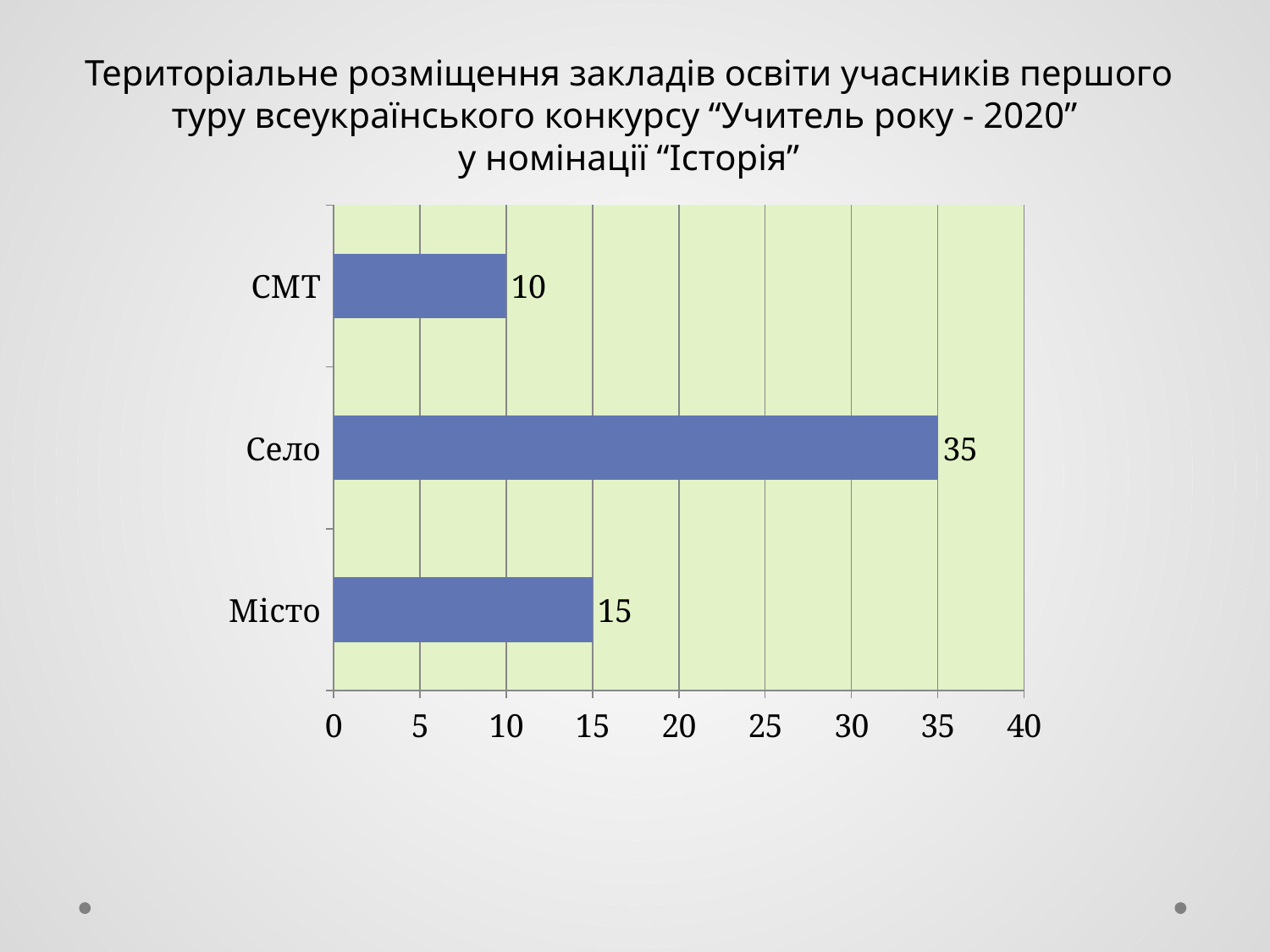
Which category has the highest value? Село What is the value for Село? 35 How many categories are shown in the chart? 3 What is the difference between the values for Місто and СМТ? 5 What is the value for Місто? 15 Which is larger, the value for Місто or the value for СМТ? Місто What is the maximum value shown on the horizontal axis? 40 What is the value for СМТ? 10 Which category has the lowest value? СМТ Is the value for Село greater or less than 30? greater What is the difference between the values for Село and Місто? 20 What kind of chart is shown on the slide? bar chart